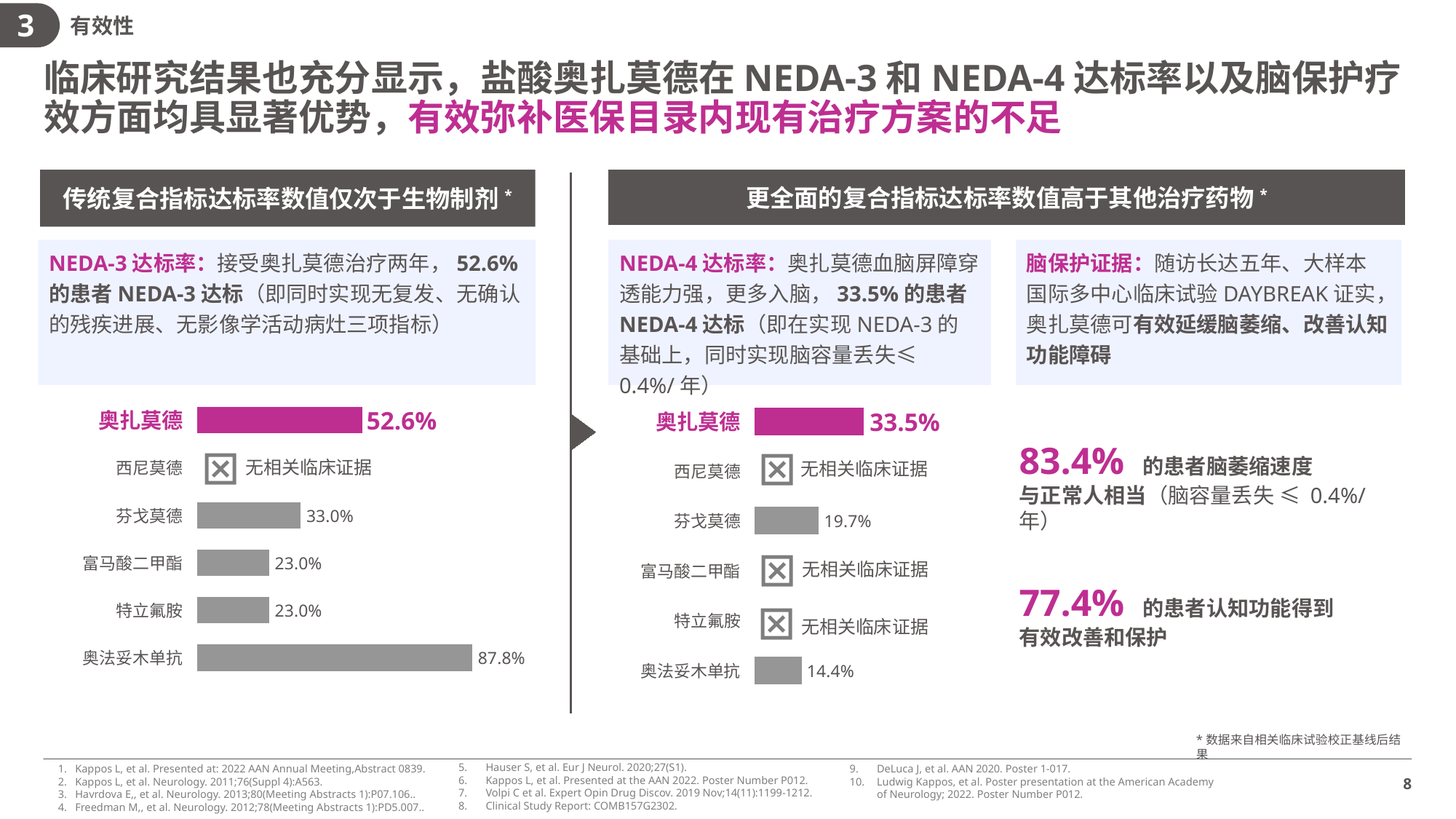
In the right chart (NEDA-4 达标率), how many drugs are marked 无相关临床证据? 3 What type of chart is used on the left side of the slide (NEDA-3 达标率)? Bar chart In the left chart (NEDA-3 达标率), what is shown for 西尼莫德 instead of a bar? 无相关临床证据 In the right chart (NEDA-4 达标率), what is the value for 奥扎莫德? 33.5% In the left chart (NEDA-3 达标率), what is the value for 奥扎莫德? 52.6% In the left chart (NEDA-3 达标率), which drug has the highest value? 奥法妥木单抗 In the left chart (NEDA-3 达标率), which is larger, 芬戈莫德 or 富马酸二甲酯? 芬戈莫德 In the left chart (NEDA-3 达标率), what is the value for 奥法妥木单抗? 87.8% In the left chart (NEDA-3 达标率), what is the difference between 奥法妥木单抗 and 奥扎莫德? 35.2% In the right chart (NEDA-4 达标率), what is the value for 芬戈莫德? 19.7% In the right chart (NEDA-4 达标率), what is the difference between 奥扎莫德 and 奥法妥木单抗? 19.1% In the right chart (NEDA-4 达标率), which drug with a plotted bar has the lowest value? 奥法妥木单抗